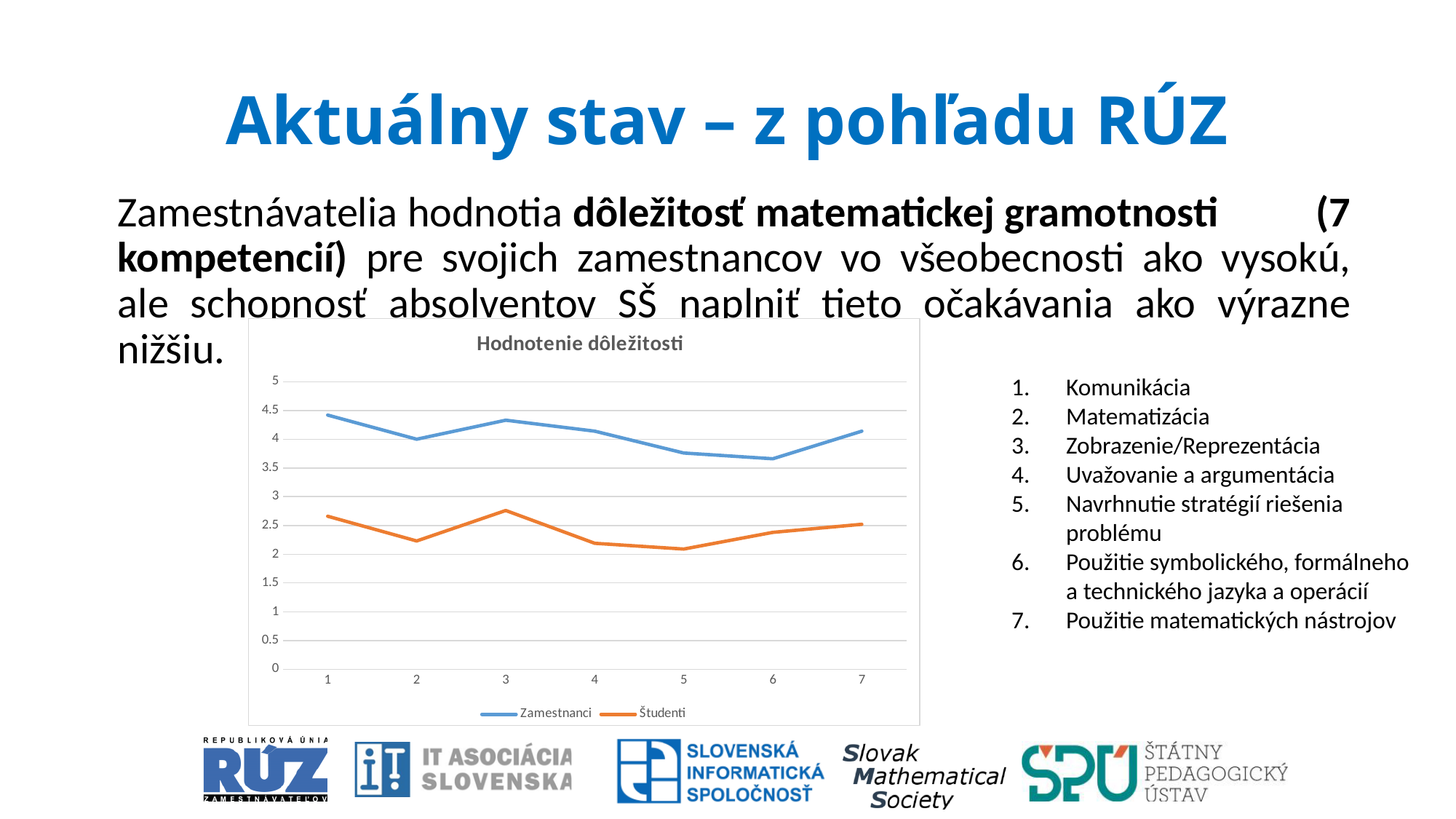
Do the Študenti values rise or fall from category 5 to category 7? rise Is the Zamestnanci value at category 1 greater or less than 4? greater How many series does the chart legend list? 2 Do the Zamestnanci values rise or fall from category 4 to category 6? fall Is the Študenti value at category 5 greater or less than 2.5? less Which series is drawn in orange in the chart? Študenti Is the Študenti value at category 3 greater or less than 2.5? greater What is the title of the chart? Hodnotenie dôležitosti What kind of chart is shown on the slide? line chart How many categories are plotted along the x axis of the chart? 7 At category 4, which series has the higher value, Zamestnanci or Študenti? Zamestnanci